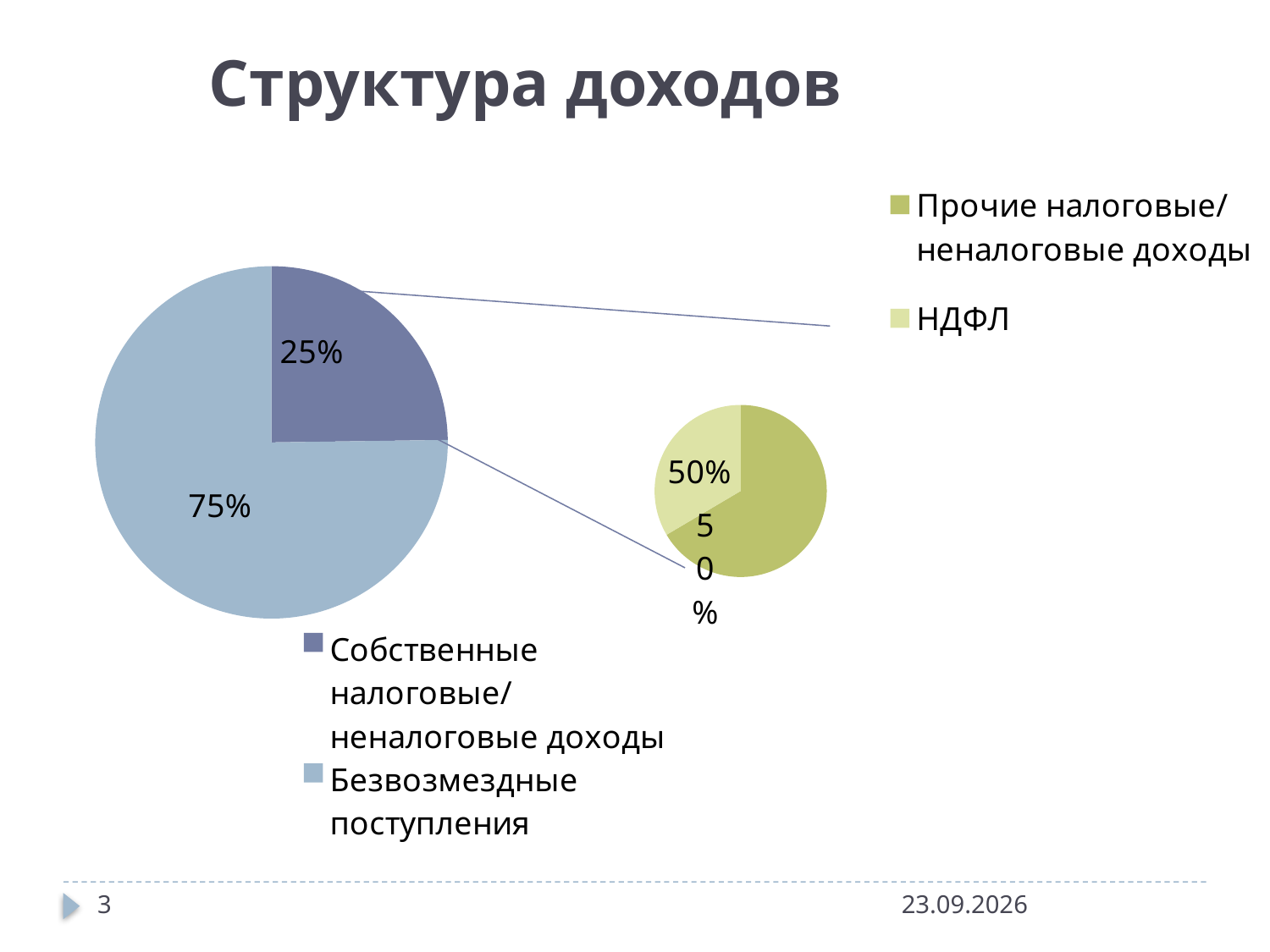
What type of chart is shown on the slide? pie chart In the main (larger) pie, what is the difference between the shares of Безвозмездные поступления and Собственные налоговые/неналоговые доходы? 50% How many categories are listed in the legend of the secondary (smaller) pie? 2 In the main (larger) pie, which is larger: Безвозмездные поступления or Собственные налоговые/неналоговые доходы? Безвозмездные поступления In the main (larger) pie, what share is labelled for Безвозмездные поступления? 75% In the main (larger) pie, what share is labelled for Собственные налоговые/неналоговые доходы? 25% In the secondary (smaller) pie, what share is labelled for НДФЛ? 50% In the secondary (smaller) pie, what share is labelled for Прочие налоговые/неналоговые доходы? 50% In the main (larger) pie, which category has the largest slice? Безвозмездные поступления In the main (larger) pie, which category has the smallest slice? Собственные налоговые/неналоговые доходы How many slices does the main (larger) pie have? 2 What is the title of the slide's chart? Структура доходов